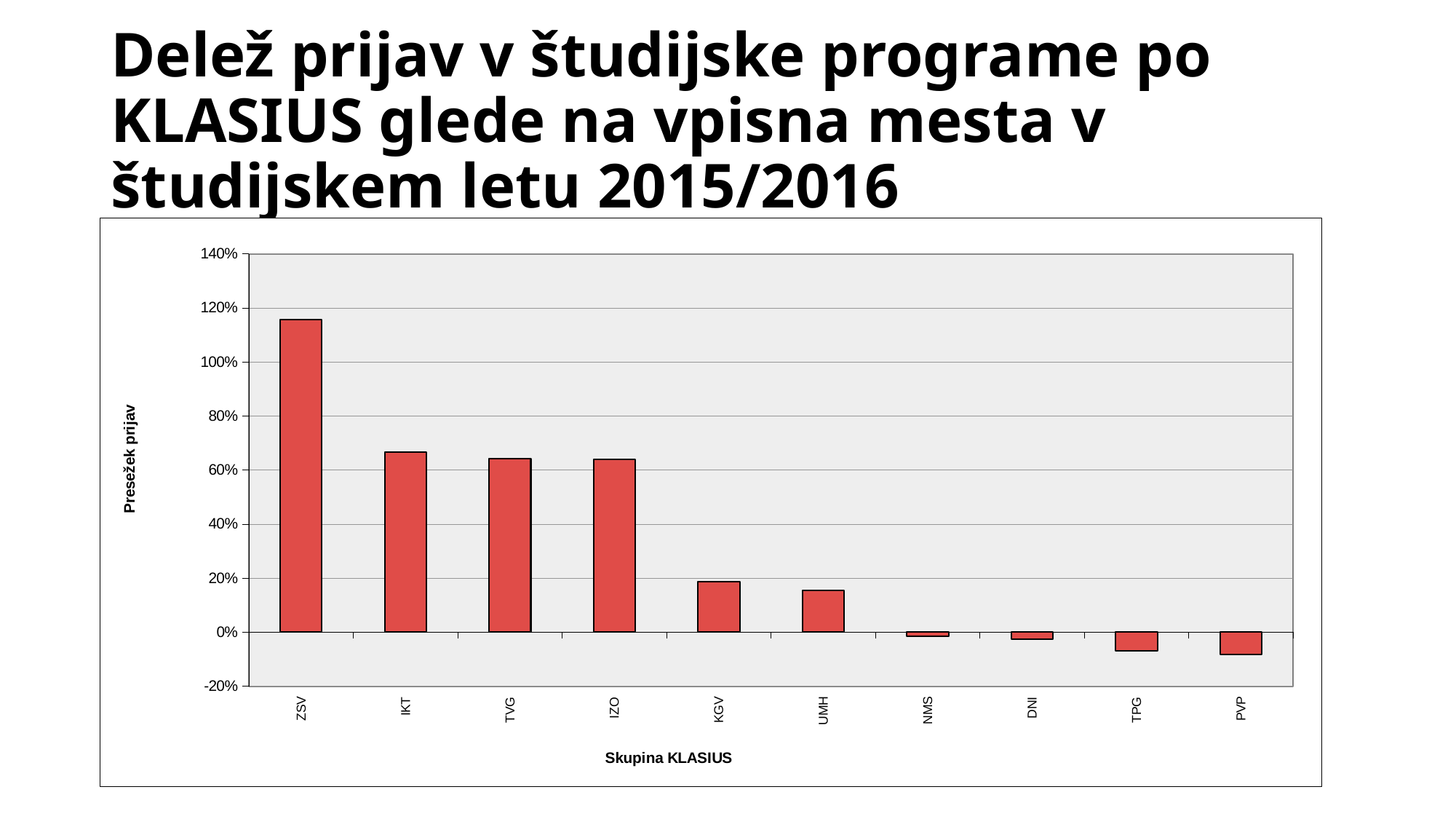
How many KLASIUS groups are plotted on the x axis? 10 Is the value for IKT greater or less than 60%? greater What is the title of the x axis? Skupina KLASIUS Which has the larger value, ZSV or IKT? ZSV Which KLASIUS group has the highest value? ZSV How many KLASIUS groups have a negative value? 4 Which has the larger value, KGV or UMH? KGV Is the value for TPG greater or less than 0%? less Is the value for KGV greater or less than 20%? less What kind of chart is shown on the slide? bar chart Do the values generally rise or fall from left to right along the x axis? fall